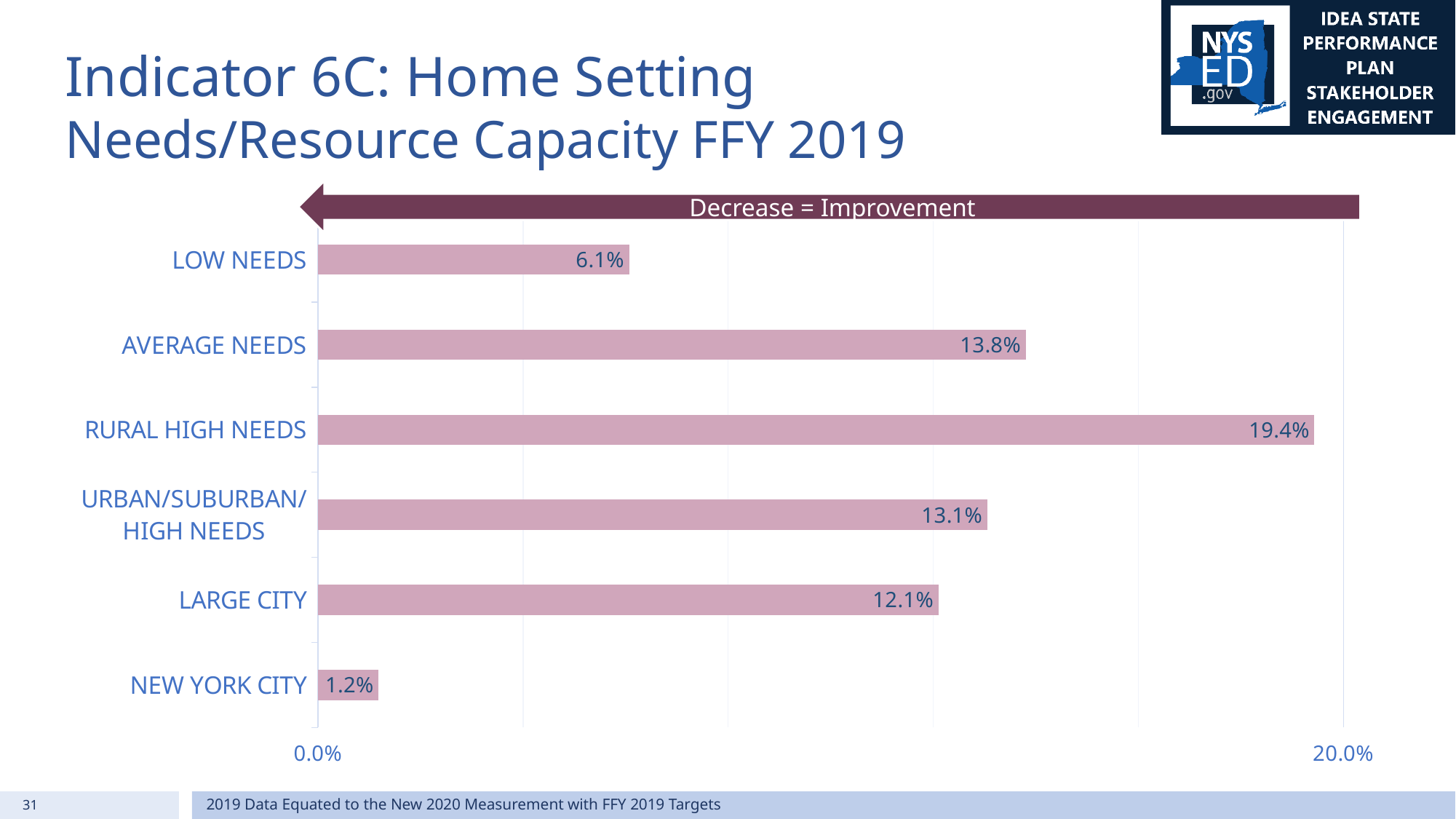
Which category has the lowest value? New York City What is the difference between the values for Rural High Needs and Low Needs? 13.3% Which category has the highest value? Rural High Needs What does the arrow above the chart say? Decrease = Improvement What is the value for Average Needs? 13.8% What kind of chart is shown on the slide? Bar chart How many categories are shown in the chart? 6 Which is larger, the value for Average Needs or the value for Urban/Suburban/High Needs? Average Needs What is the difference between the values for Urban/Suburban/High Needs and Large City? 1.0% What is the value for Large City? 12.1% What is the value for Rural High Needs? 19.4% What is the value for New York City? 1.2%